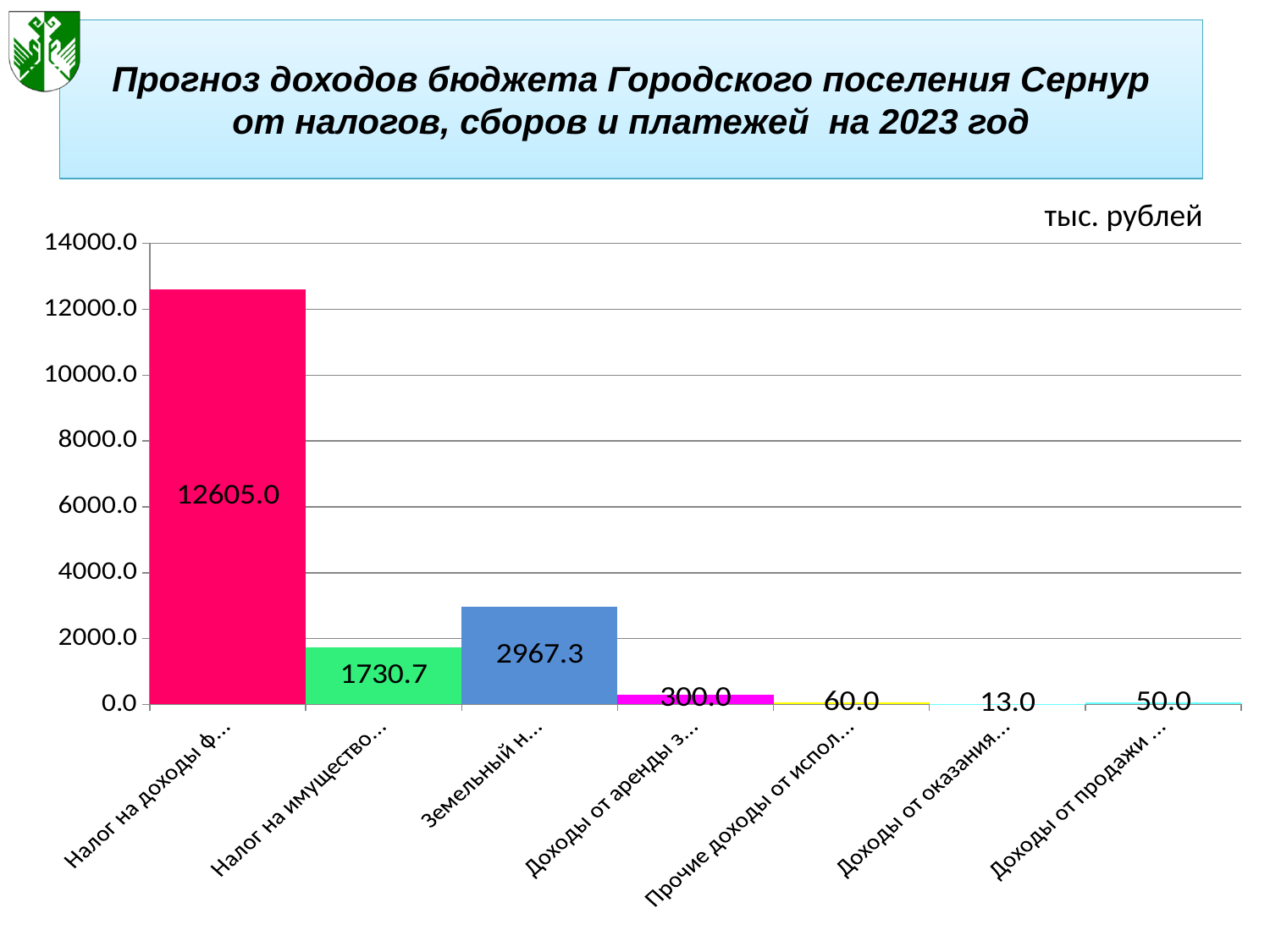
What type of chart is shown on the slide? bar chart How many categories (bars) are shown in the chart? 7 What is the value of the bar labelled 'Земельный н...'? 2967.3 Which is larger: the value for 'Доходы от аренды з...' or the value for 'Прочие доходы от испол...'? Доходы от аренды з... Which category has the highest value? Налог на доходы ф... What is the difference between the values for 'Земельный н...' and 'Налог на имущество...'? 1236.6 What is the value of the bar labelled 'Налог на имущество...'? 1730.7 Is the value for the first bar (Налог на доходы ф...) greater or less than 12000.0? greater What is the value of the first bar (Налог на доходы ф...)? 12605.0 Which category has the lowest value? Доходы от оказания... What unit is indicated above the chart? тыс. рублей What is the value of the bar labelled 'Доходы от оказания...'? 13.0